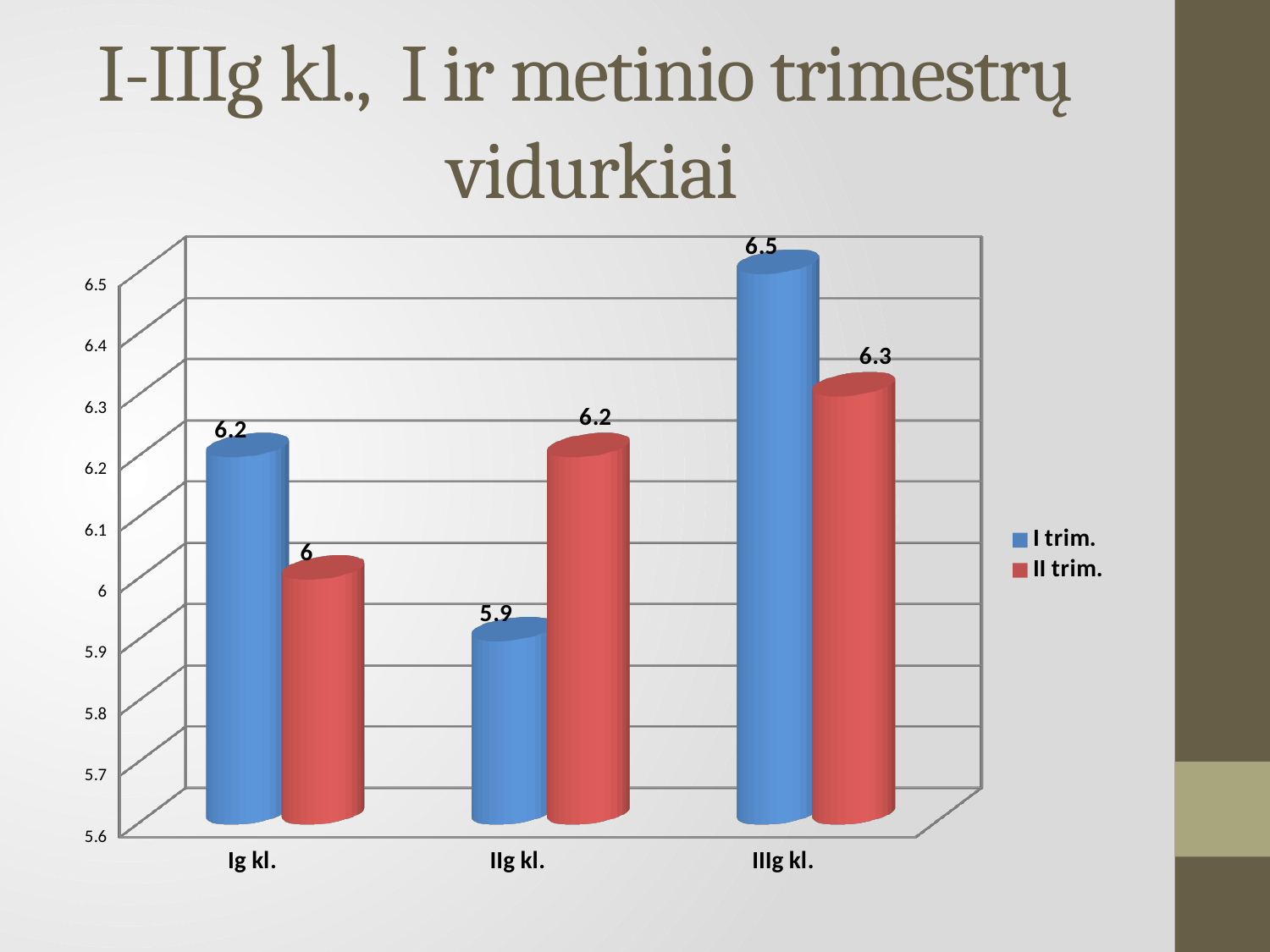
What kind of chart is shown on the slide? Bar chart How many series does the legend list? 2 What is the value for II trim. for IIIg kl.? 6.3 What is the value for I trim. for IIg kl.? 5.9 What is the value for I trim. for Ig kl.? 6.2 How many categories are shown on the x axis? 3 What is the value for II trim. for Ig kl.? 6 What is the difference between the I trim. and II trim. values for IIIg kl.? 0.2 Which is larger for IIg kl., the I trim. value or the II trim. value? II trim. What colour are the II trim. bars? Red Which category has the highest I trim. value? IIIg kl. Which category has the lowest II trim. value? Ig kl.